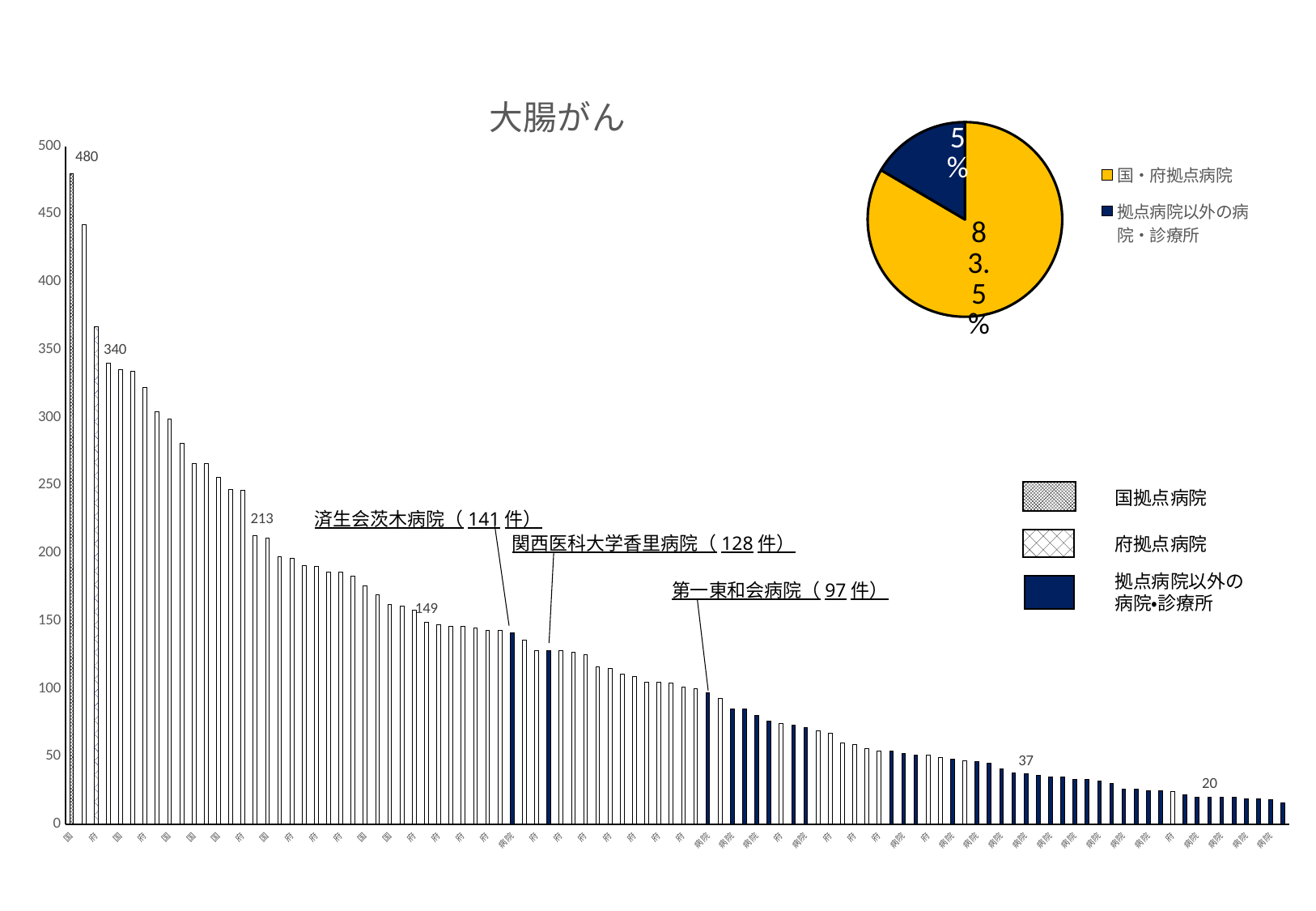
In the 大腸がん bar chart, what is the difference between the values for 済生会茨木病院 and 関西医科大学香里病院? 13 In the 大腸がん bar chart, do the bar values rise or fall from left to right? fall In the 大腸がん bar chart, which has the larger value, 済生会茨木病院 or 第一東和会病院? 済生会茨木病院 In the 大腸がん bar chart, how many cases are shown for 第一東和会病院? 97 件 In the pie chart, what share does 国・府拠点病院 have? 83.5% In the 大腸がん bar chart, how many cases are shown for 済生会茨木病院? 141 件 In the 大腸がん bar chart, is the value for 第一東和会病院 greater or less than 100? less In the 大腸がん bar chart, how many cases are shown for 関西医科大学香里病院? 128 件 What kind of chart is the large chart titled 大腸がん on the left of the slide? bar chart What kind of chart is shown in the top right of the slide? pie chart In the 大腸がん bar chart, what is the value of the highest bar? 480 How many entries does the legend of the pie chart list? 2